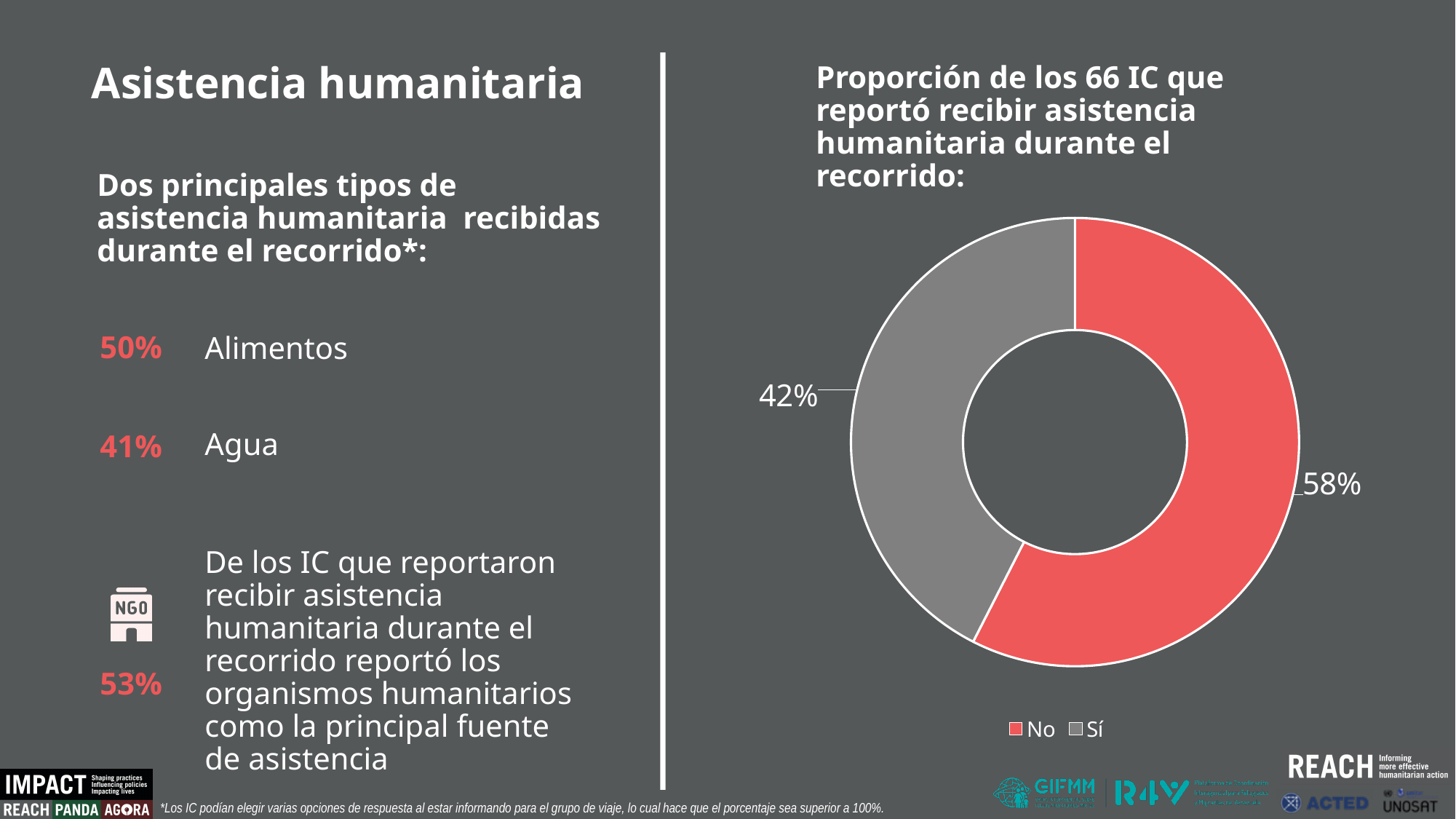
What percentage of the 66 IC reported not receiving humanitarian assistance during the journey (No)? 58% What percentage of the 66 IC reported receiving humanitarian assistance during the journey (Sí)? 42% Is the share for Sí greater or less than 50%? less What is the difference in percentage points between the No and Sí slices? 16 percentage points Which category has the smaller share of the pie? Sí How many slices does the pie chart have? 2 What kind of chart is shown on the slide? Pie chart (donut) How many entries does the legend list? 2 What colour is the Sí slice in the pie chart? Grey What colour is the No slice in the pie chart? Red Which category has the larger share of the pie, No or Sí? No